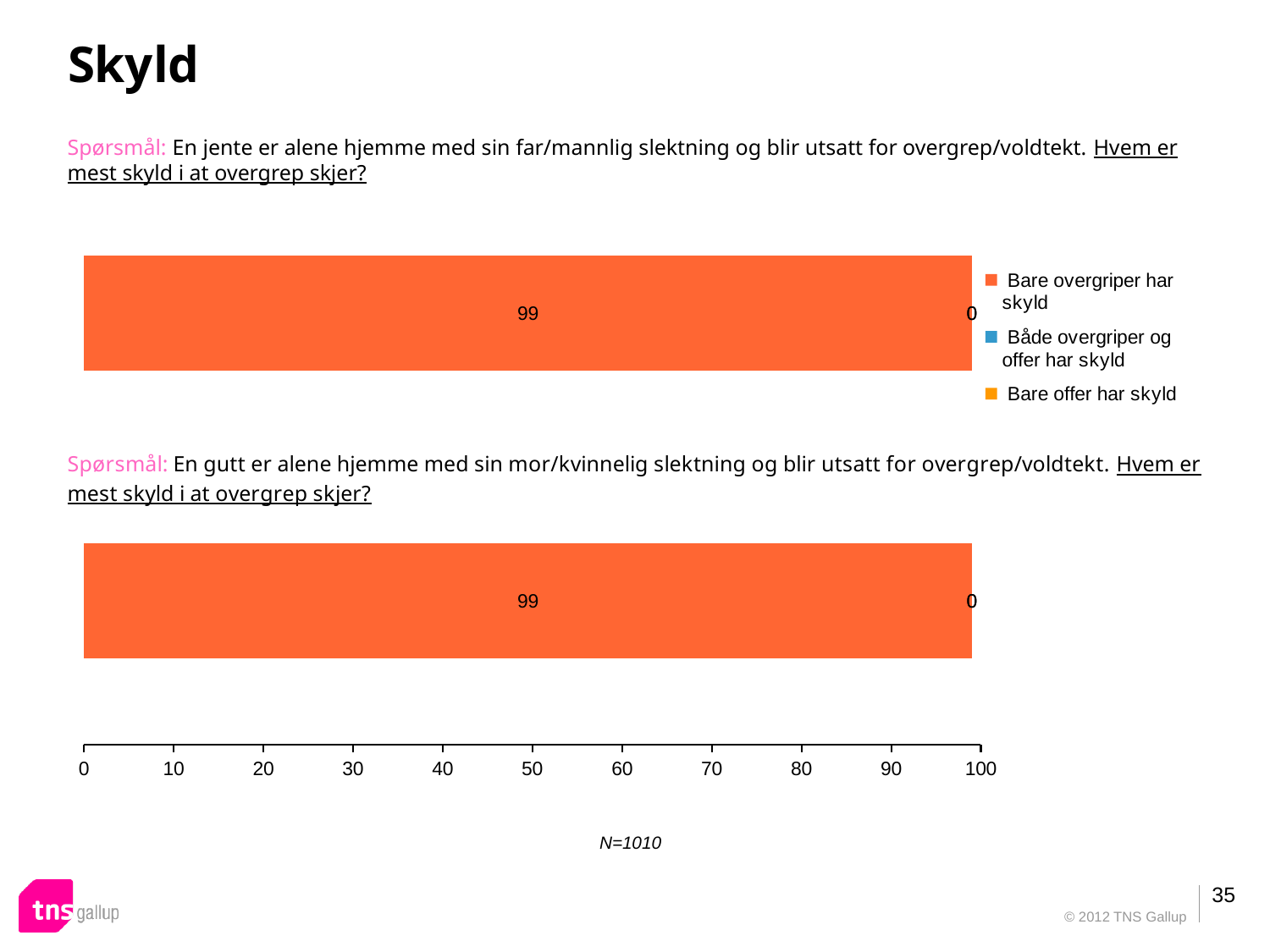
Is the value for "Bare overgriper har skyld" the same in the top chart and the bottom chart? Yes In the bottom chart, what is the value for "Bare overgriper har skyld"? 99 In the top chart, is the value for "Bare overgriper har skyld" greater or less than 90? greater In the top chart, which series has the highest value? Bare overgriper har skyld In the top chart, what is the difference between the value labelled 99 and the value labelled 0? 99 In the bottom chart, is the value for "Bare overgriper har skyld" greater or less than 50? greater In the top chart, what is the value for "Bare overgriper har skyld"? 99 How many series does the legend list? 3 In the bottom chart, which series has the highest value? Bare overgriper har skyld What kind of chart is shown on the slide? Bar chart What sample size (N) is stated below the charts? N=1010 What colour represents "Bare overgriper har skyld" in the legend? Orange